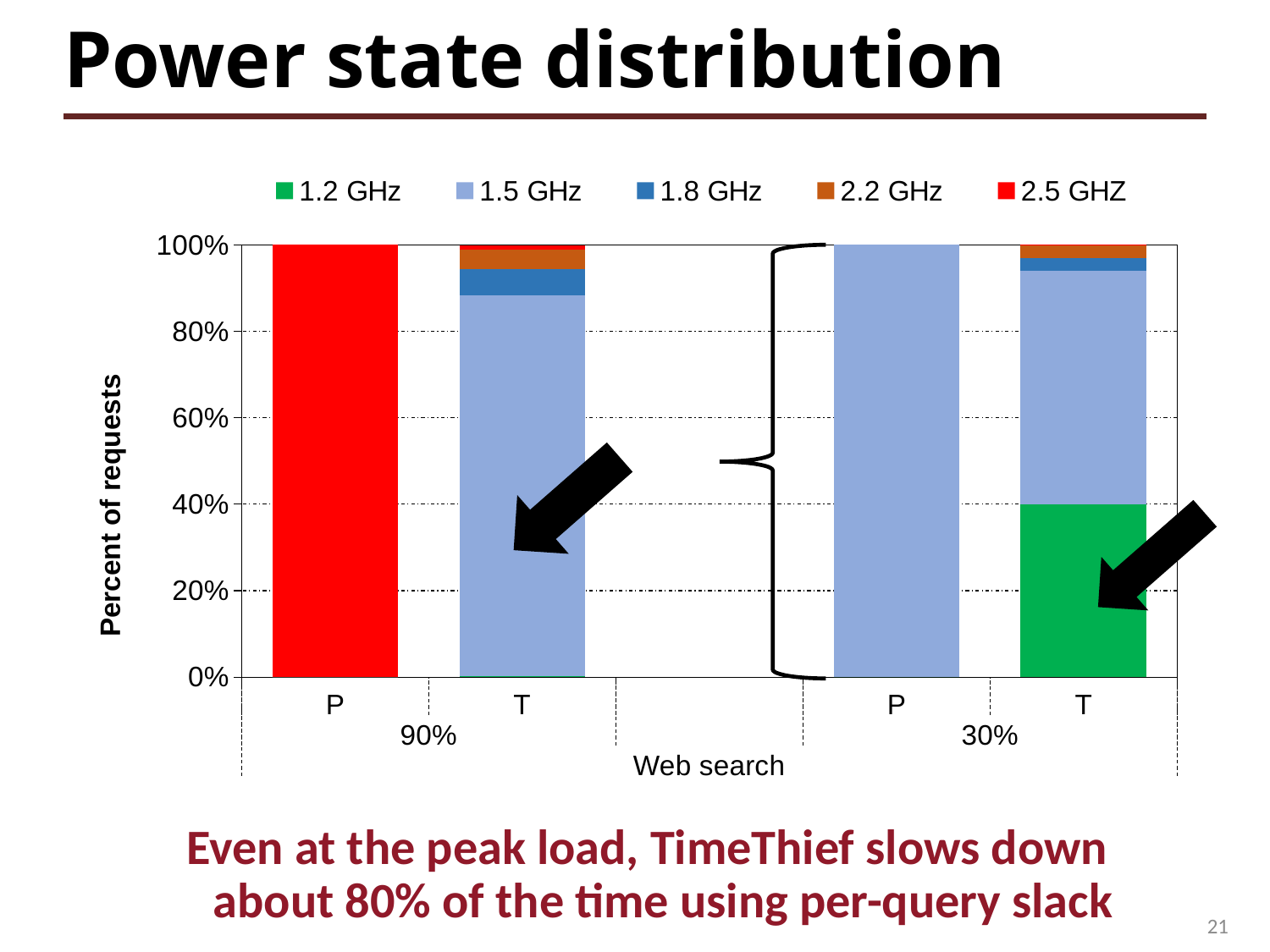
What percent of requests are at 2.5 GHz in the P bar under 90% load? 100% Is the 1.2 GHz share in the T bar under 90% load greater or less than 20%? less What percent of requests are at 1.5 GHz in the P bar under 30% load? 100% What percent of requests does the 1.2 GHz segment account for in the T bar under 30% load? 40% Which frequency does the red colour represent in the legend? 2.5 GHZ What is the y-axis title of the chart? Percent of requests How many series does the legend list? 5 Is the 1.5 GHz share in the T bar under 90% load greater or less than 80%? greater Which bar has the larger 1.2 GHz segment, T under 90% load or T under 30% load? T under 30% load What kind of chart is shown on the slide? Stacked bar chart What is the total height of the T bar under 90% load? 100% How many bars are plotted in the chart? 4